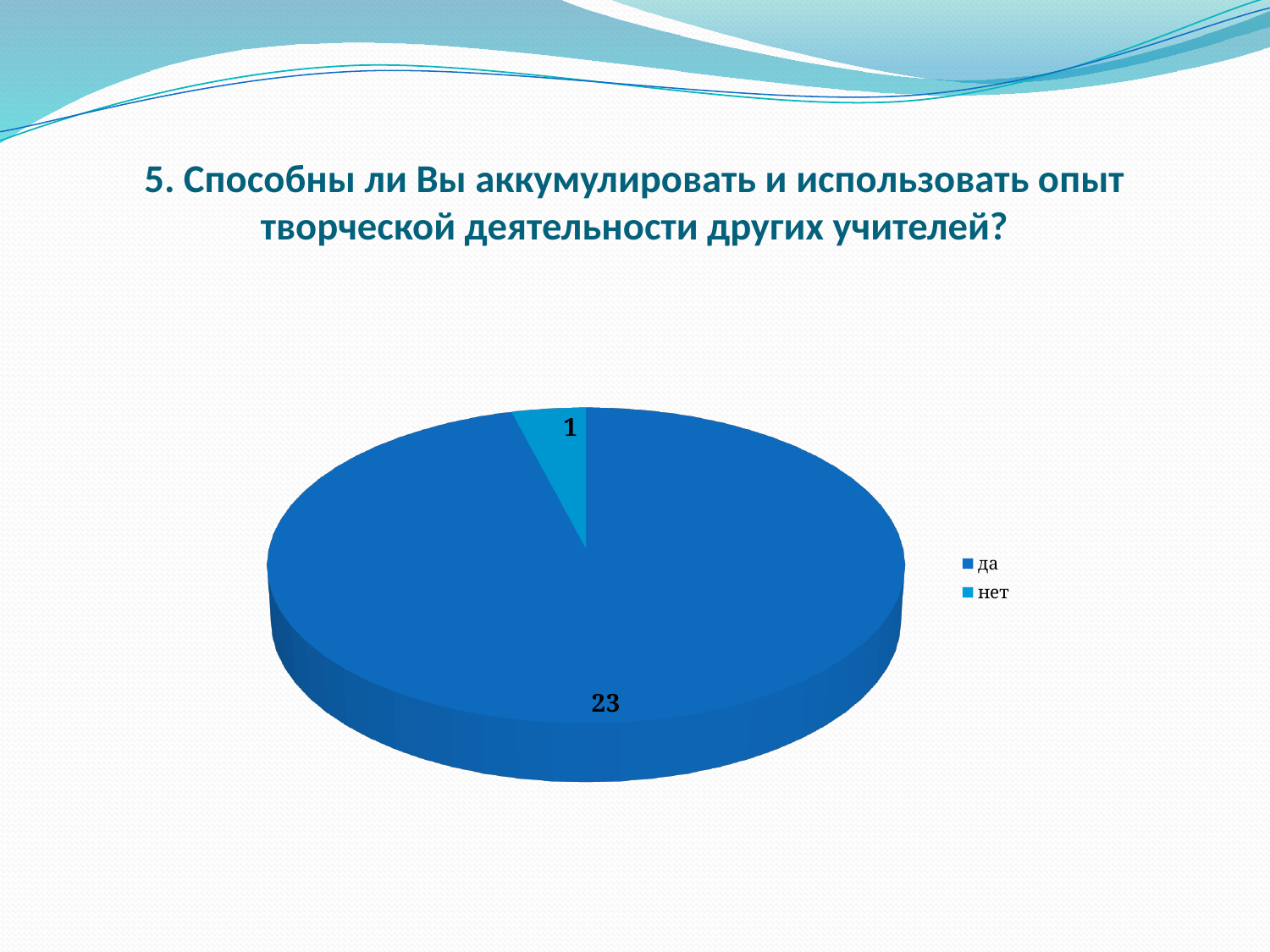
Which category has the largest slice? да Which legend entry is listed first? да What is the difference between the values for "да" and "нет"? 22 What is the value for "да"? 23 How many categories does the pie chart have? 2 Which is larger, the value for "да" or the value for "нет"? да What is the title of the slide above the chart? 5. Способны ли Вы аккумулировать и использовать опыт творческой деятельности других учителей? What is the total of all slices in the pie chart? 24 How many entries does the legend list? 2 What is the value for "нет"? 1 Which category has the smallest slice? нет What kind of chart is shown on the slide? pie chart